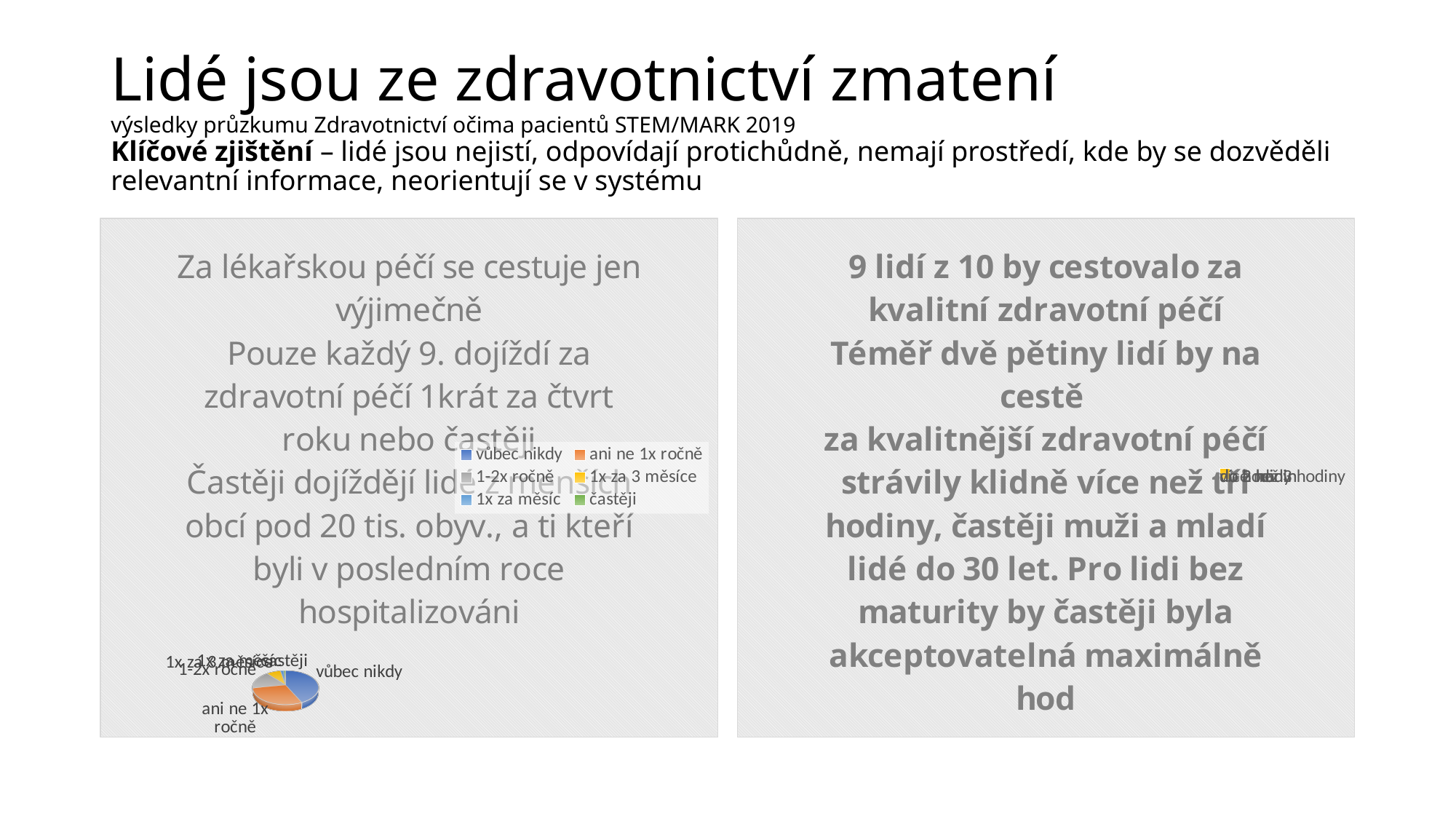
In the pie chart in the left panel, which slice is larger: 'vůbec nikdy' or 'častěji'? vůbec nikdy What kind of chart is shown in the left panel of the slide? pie chart How many categories does the legend of the pie chart in the left panel list? 6 In the pie chart in the left panel, which slice is larger: 'ani ne 1x ročně' or '1x za měsíc'? ani ne 1x ročně In the pie chart in the left panel, which category has the largest slice? vůbec nikdy In the pie chart in the left panel, what colour represents the category 'vůbec nikdy' in the legend? blue In the pie chart in the left panel, what colour represents the category 'ani ne 1x ročně' in the legend? orange